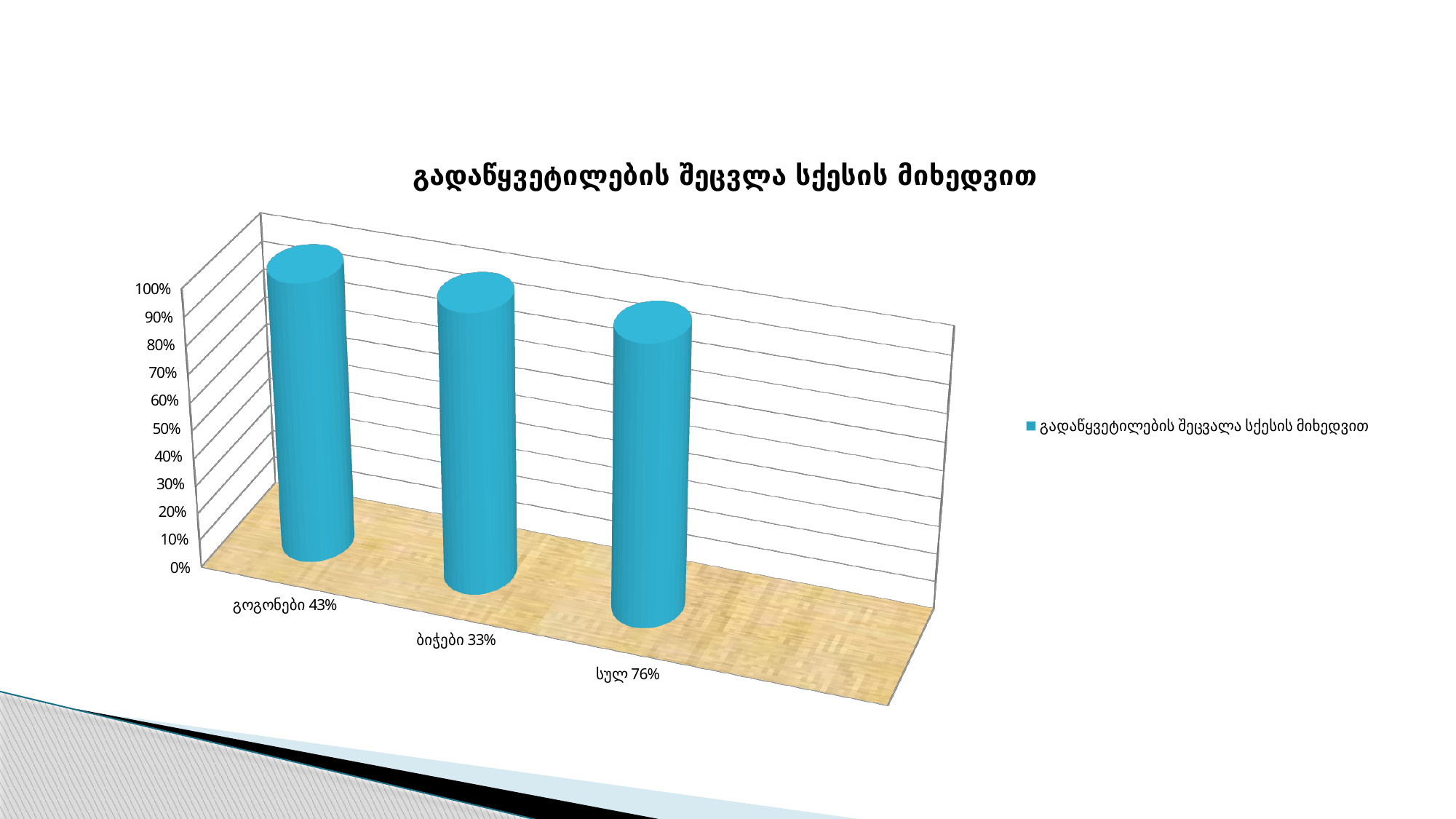
What is the legend entry of the chart? გადაწყვეტილების შეცვალა სქესის მიხედვით What is the title of the chart? გადაწყვეტილების შეცვლა სქესის მიხედვით Is the bar for გოგონები greater or less than 50%? greater What percentage is printed in the category label for ბიჭები? 33% What is the highest value shown on the vertical axis? 100% Which category label shows the higher percentage, გოგონები or ბიჭები? გოგონები How many categories are shown on the x axis of the chart? 3 What percentage is printed in the category label for გოგონები? 43% What kind of chart is shown on the slide? bar chart How many series does the legend list? 1 What is the difference between the percentages printed for გოგონები and ბიჭები? 10% What percentage is printed in the category label for სულ? 76%